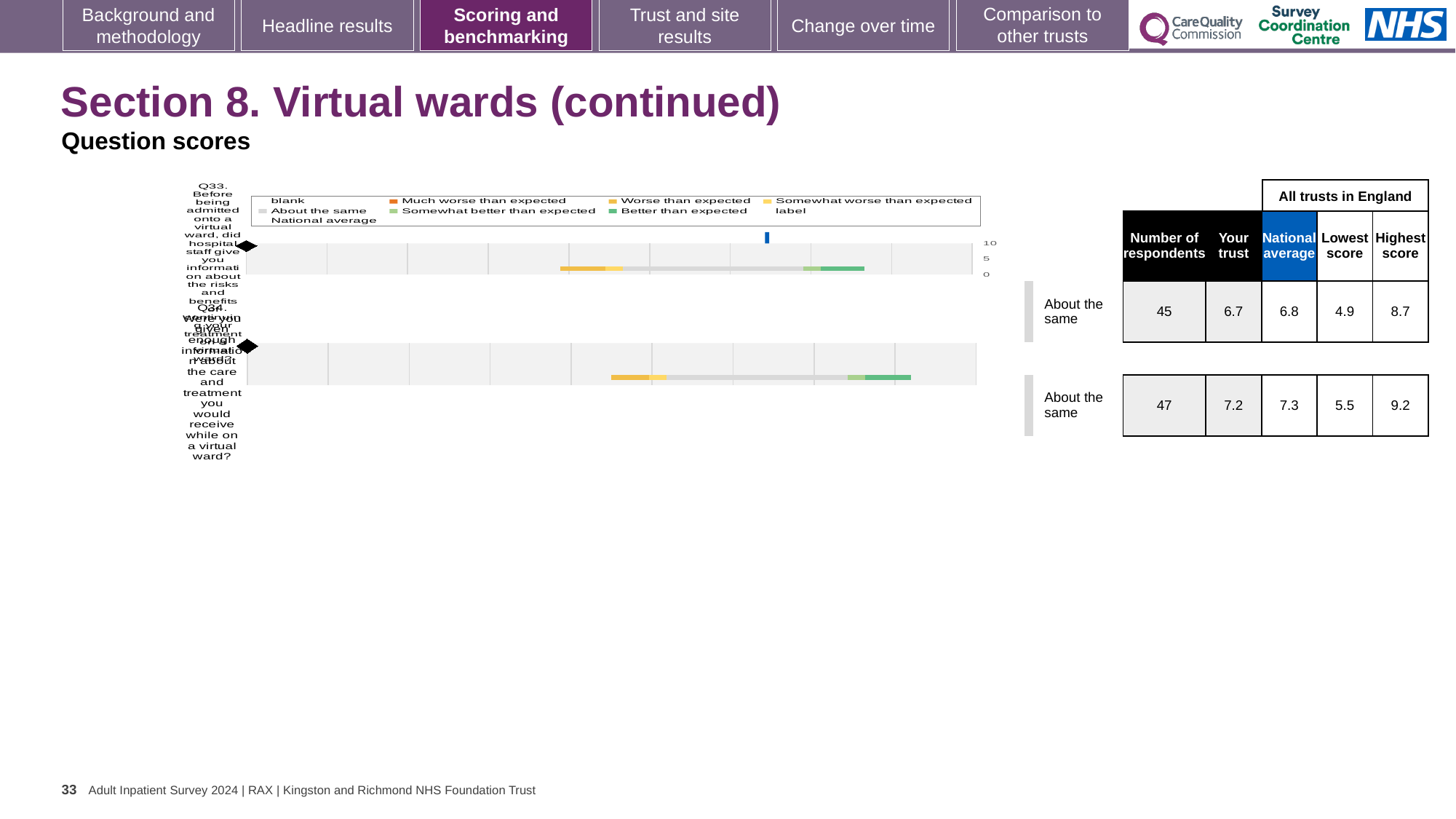
Which question has the higher 'Your trust' score, Q33 or Q34? Q34 What is the lowest score across all trusts in England for Q34? 5.5 What is the difference between the highest and lowest scores for Q34? 3.7 How many questions are plotted on the slide? 2 What kind of chart is used to show the question scores for Q33 and Q34? bar chart What is the 'Your trust' score for Q33? 6.7 How many respondents answered Q34? 47 What benchmark category is shown for Q33? About the same What is the highest score across all trusts in England for Q33? 8.7 What is the 'Your trust' score for Q34? 7.2 What colour represents 'Better than expected' in the legend? green What is the national average for Q33? 6.8